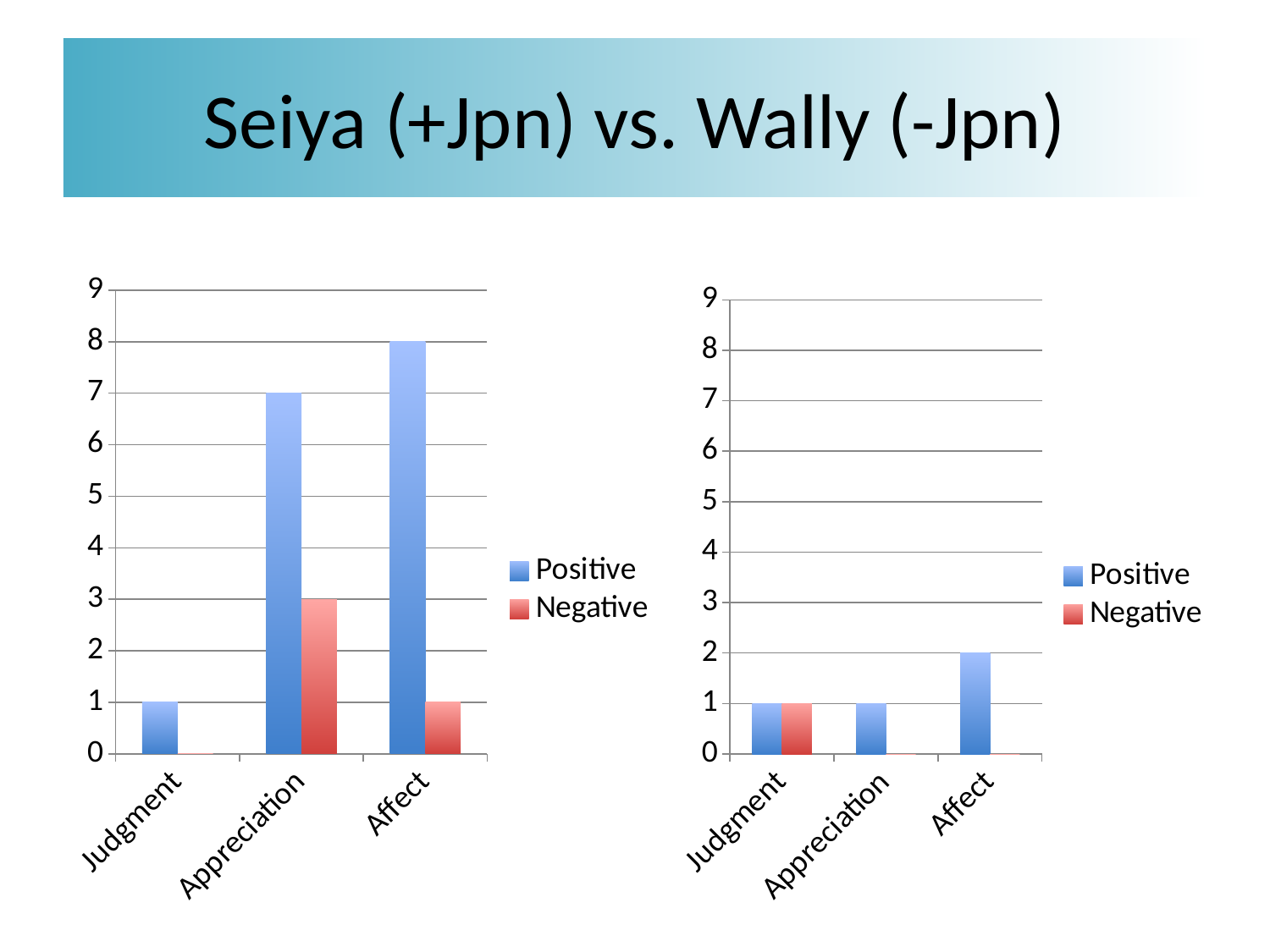
How many series does the legend of the left chart list? 2 What kind of chart is the right chart? Bar chart On the left chart, which category has the highest Positive value? Affect On the left chart, what is the Positive value for Affect? 8 On the left chart, which category has the lowest Positive value? Judgment How many categories are shown on the x axis of the right chart? 3 On the left chart, do the Positive values rise or fall from Judgment to Affect? Rise On the right chart, what is the Positive value for Affect? 2 On the left chart, what is the Negative value for Appreciation? 3 On the left chart, is the Positive value for Appreciation greater or less than 5? greater On the right chart, which is larger for Judgment: the Positive value or the Negative value? They are equal On the left chart, what is the difference between the Positive and Negative values for Appreciation? 4